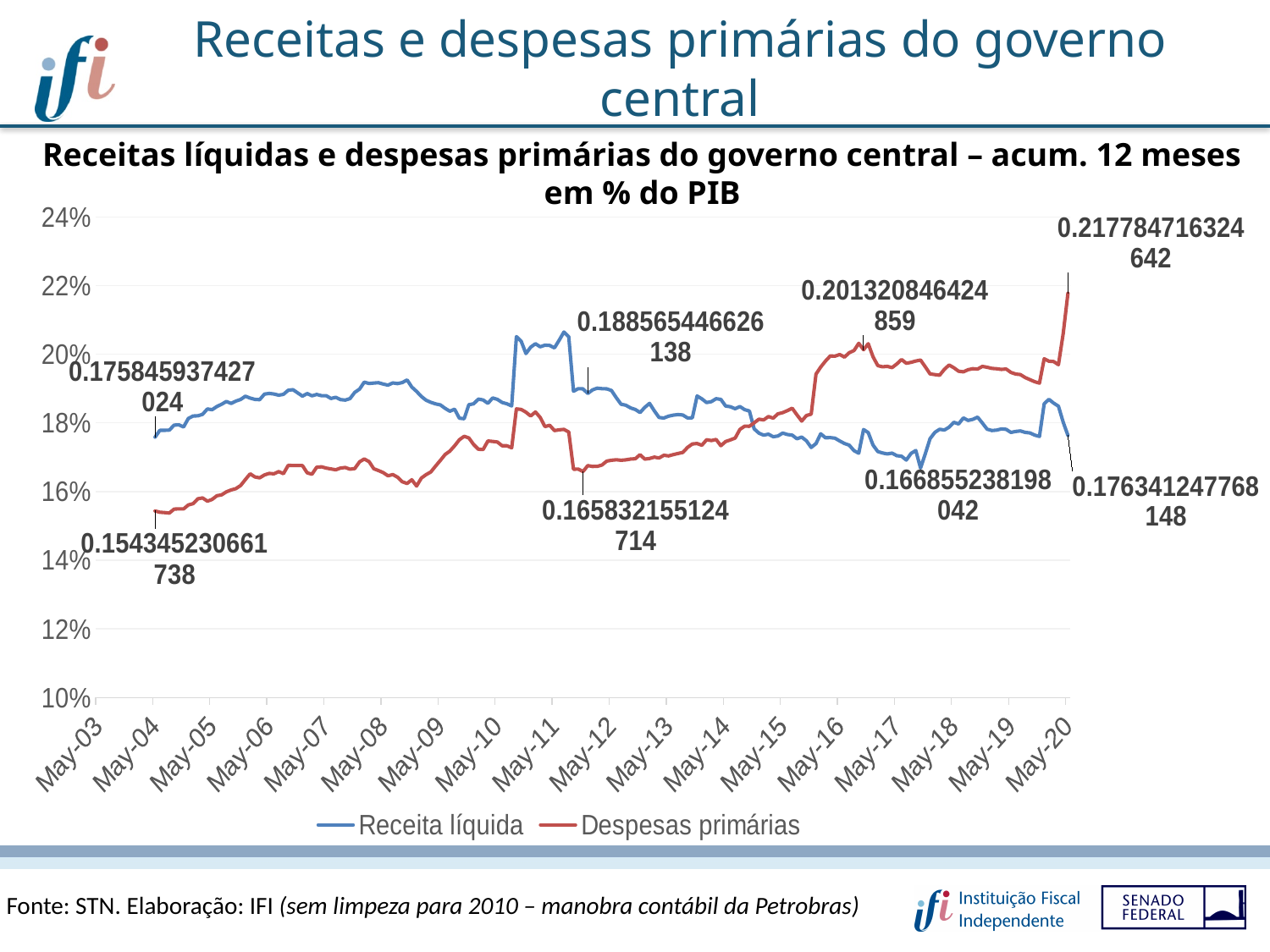
What is the data label for Receita líquida at May-20? 0.176341247768148 At May-20, which series has the higher value, Receita líquida or Despesas primárias? Despesas primárias What is the data label for Despesas primárias at May-04? 0.154345230661738 At May-04, which series has the higher value, Receita líquida or Despesas primárias? Receita líquida What is the data label for Despesas primárias at May-20? 0.217784716324642 Is the value for Despesas primárias at May-20 greater or less than 20%? greater Does the Despesas primárias line generally rise or fall from May-04 to May-20? rise What are the two series named in the legend? Receita líquida and Despesas primárias How many series does the legend list? 2 What kind of chart is shown on the slide? line chart